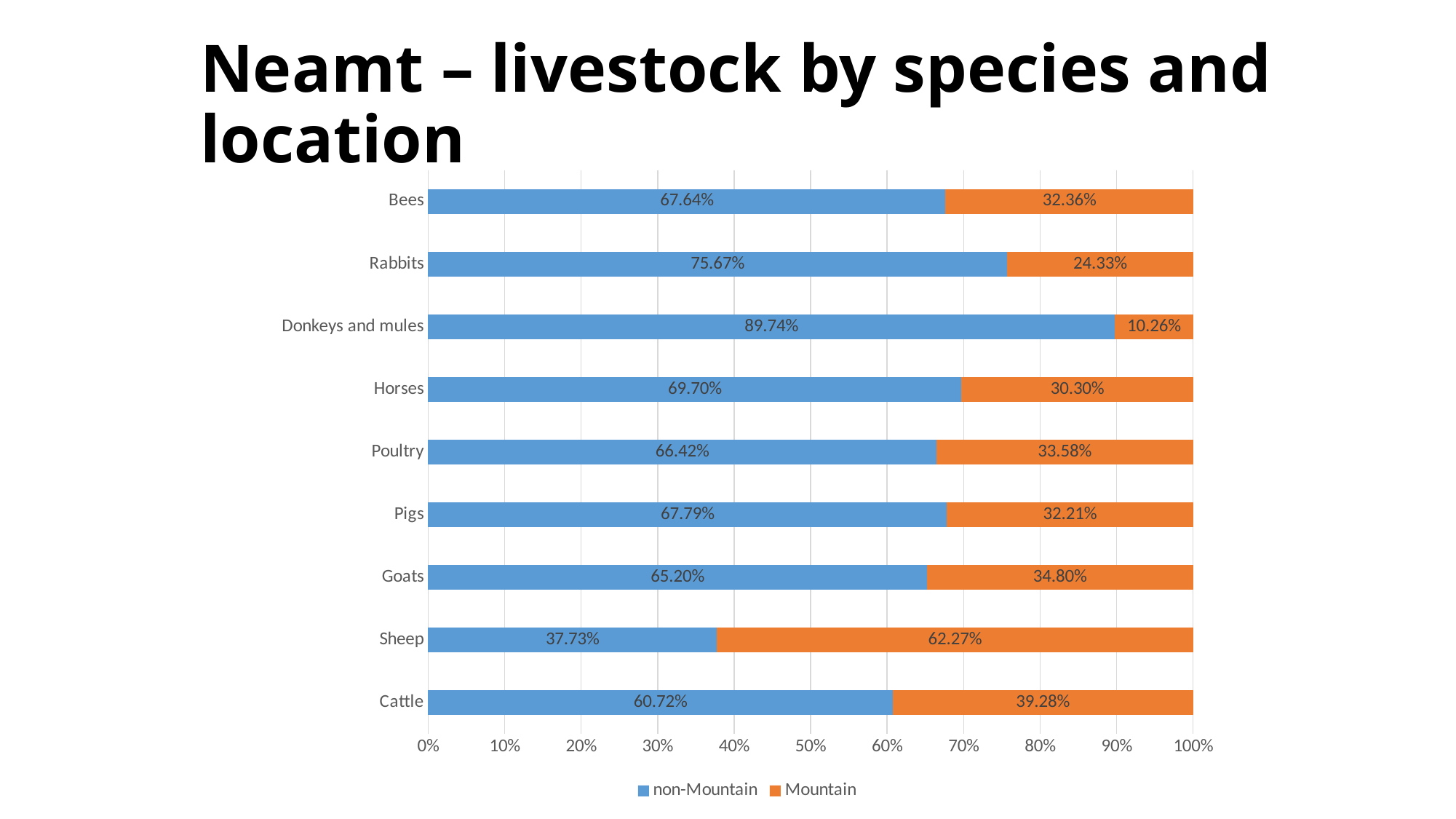
What is the Mountain share for Sheep? 62.27% Which species has the highest Mountain share? Sheep What is the difference between the Mountain share for Cattle and the Mountain share for Bees? 6.92% Which colour represents the Mountain series in the legend? Orange How many species are shown on the chart? 9 Which species has the lowest Mountain share? Donkeys and mules Which is larger: the non-Mountain share for Rabbits or the non-Mountain share for Horses? Rabbits What is the total of the Sheep bar (non-Mountain plus Mountain)? 100% What is the non-Mountain share for Donkeys and mules? 89.74% How many series does the legend list? 2 What is the non-Mountain share for Cattle? 60.72% What kind of chart is shown on the slide? Stacked bar chart